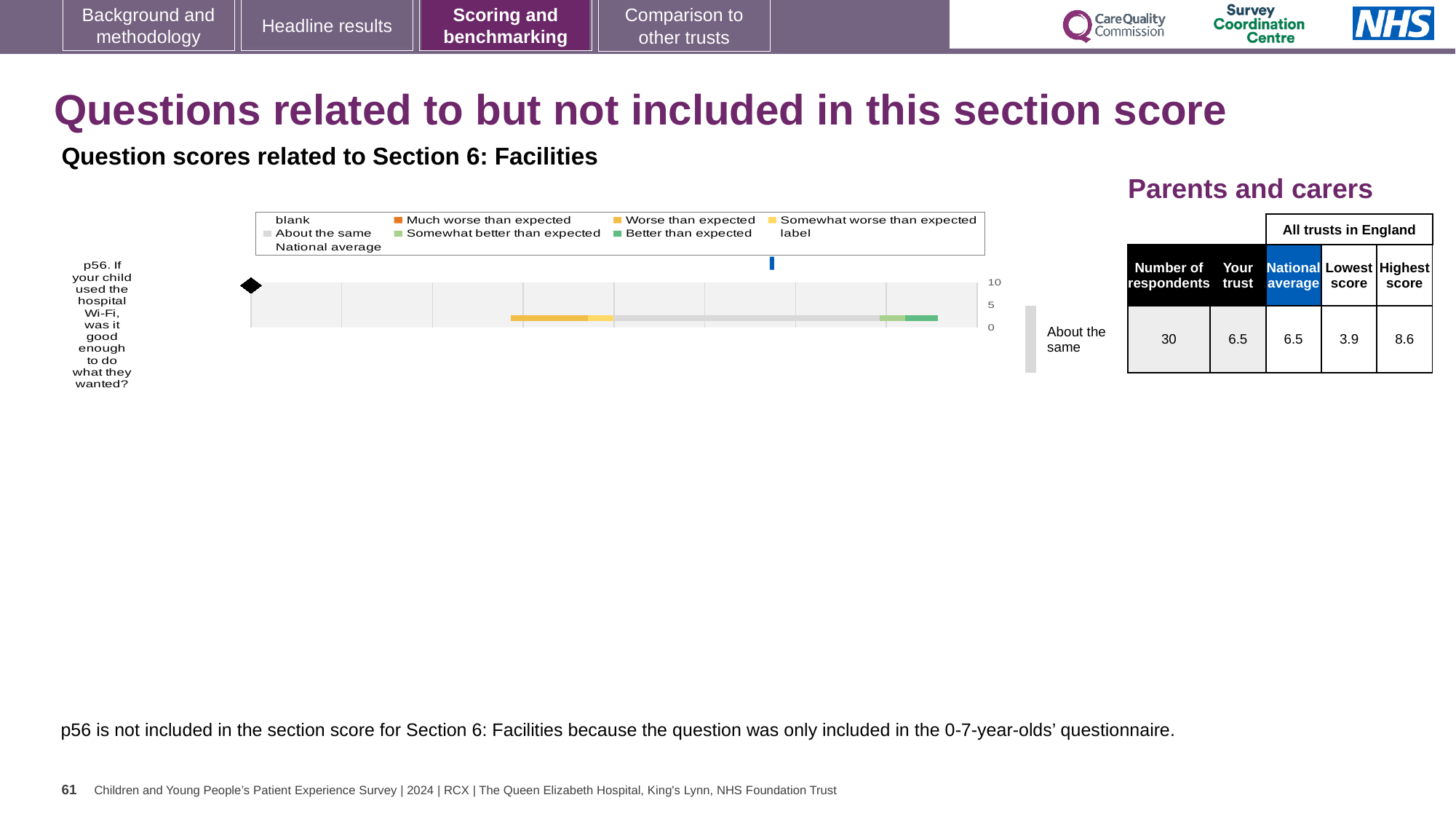
What is the number of respondents for p56 shown in the table? 30 What is the difference between the highest score and the lowest score for p56? 4.7 Which is larger for p56: the 'Your trust' score or the lowest score? Your trust What is the lowest score among all trusts in England for p56? 3.9 What is the 'Your trust' score for p56? 6.5 What is the difference between the highest score and the 'Your trust' score for p56? 2.1 What is the national average score for p56? 6.5 What kind of chart is used to show the p56 benchmarking result? bar chart What benchmarking category is the trust's p56 result placed in? About the same How many questions (categories) are plotted on the chart? 1 What is the highest score among all trusts in England for p56? 8.6 What is the highest value shown on the chart's score axis? 10